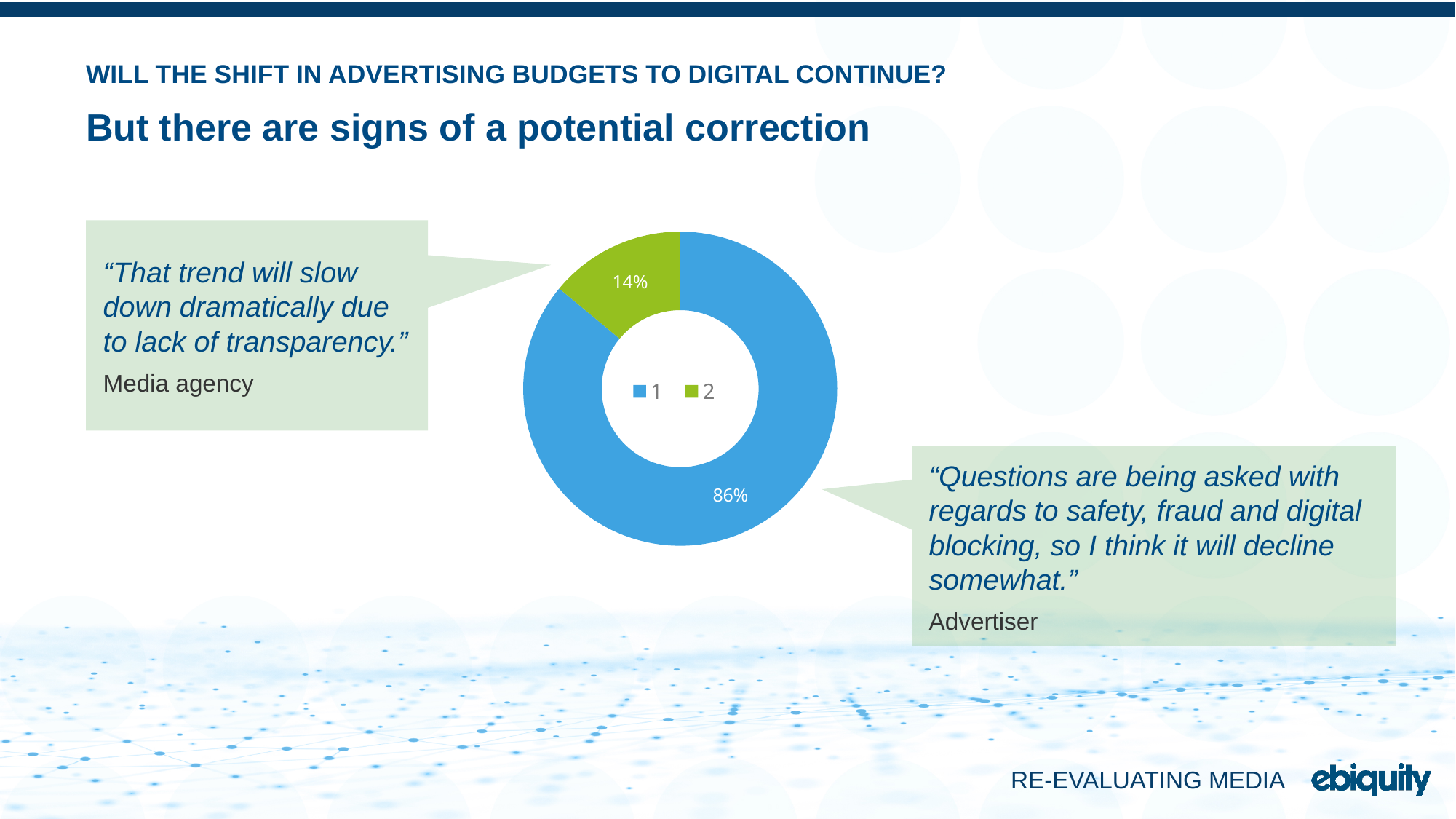
What colour is the slice labelled 2 in the chart? Green How many slices does the chart have? 2 How many entries does the chart legend list? 2 What percentage is shown for the green slice labelled 2? 14% Which slice of the chart is the largest? 1 What share of the chart does slice 2 represent? 14% What percentage is shown for the blue slice labelled 1? 86% Which is larger, slice 1 or slice 2? 1 What is the difference in percentage points between slice 1 and slice 2? 72 What type of chart is shown on the slide? Pie chart (donut) What colour is the slice labelled 1 in the chart? Blue Which slice of the chart is the smallest? 2